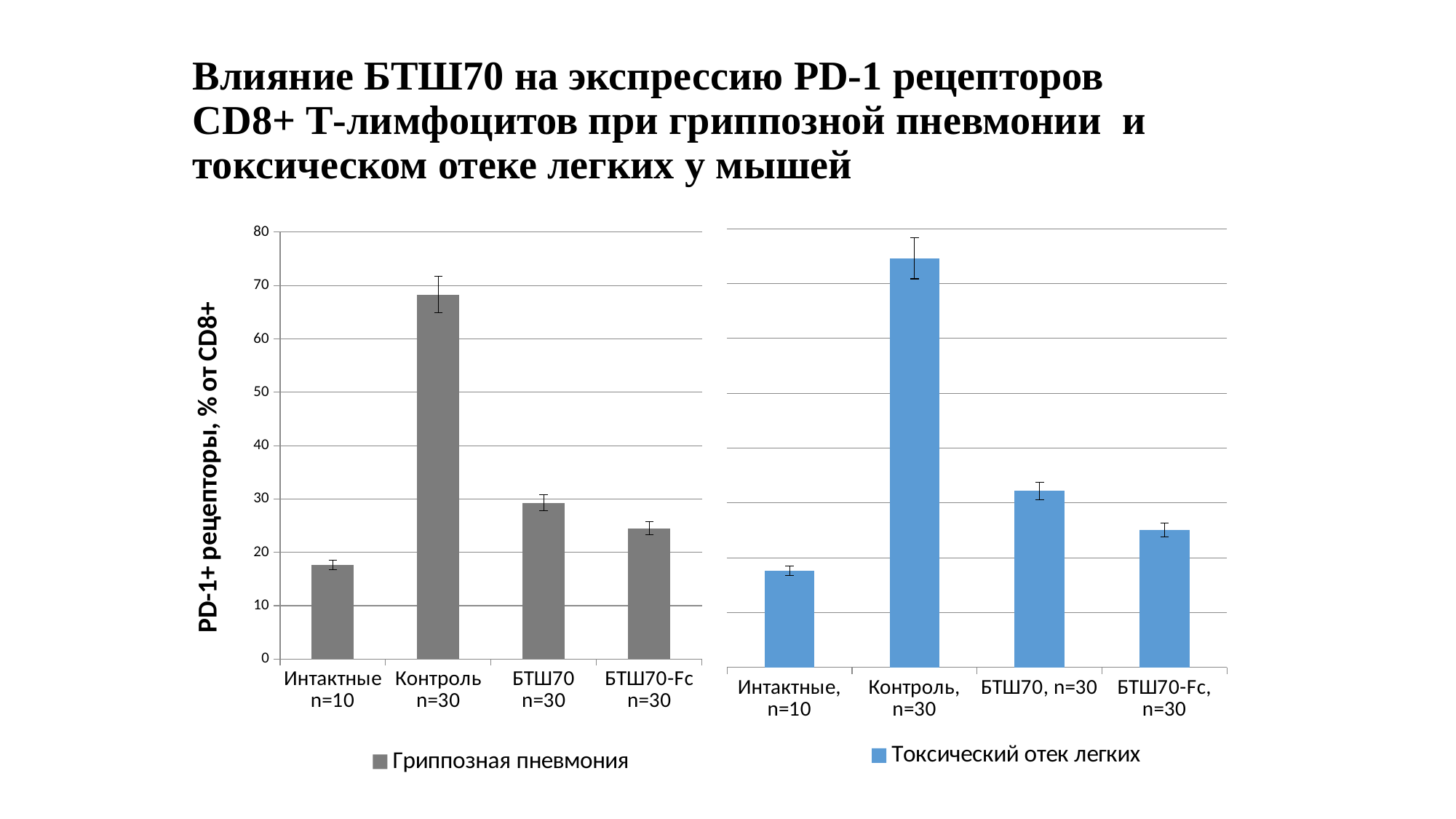
What type of chart is the left chart (Гриппозная пневмония)? Bar chart In the left chart (Гриппозная пневмония), which is larger: the value for БТШ70 n=30 or the value for БТШ70-Fc n=30? БТШ70 n=30 In the right chart (Токсический отек легких), which category has the lowest value? Интактные, n=10 In the left chart (Гриппозная пневмония), which category has the highest value? Контроль n=30 In the right chart (Токсический отек легких), is the value for Контроль, n=30 greater or less than 70? greater In the left chart (Гриппозная пневмония), is the value for Интактные n=10 greater or less than 20? less In the right chart (Токсический отек легких), is the value for БТШ70, n=30 greater or less than 30? greater In the right chart (Токсический отек легких), which category has the highest value? Контроль, n=30 What is the y-axis label of the left chart? PD-1+ рецепторы, % от CD8+ In the left chart (Гриппозная пневмония), which category has the lowest value? Интактные n=10 How many categories are shown in the right chart (Токсический отек легких)? 4